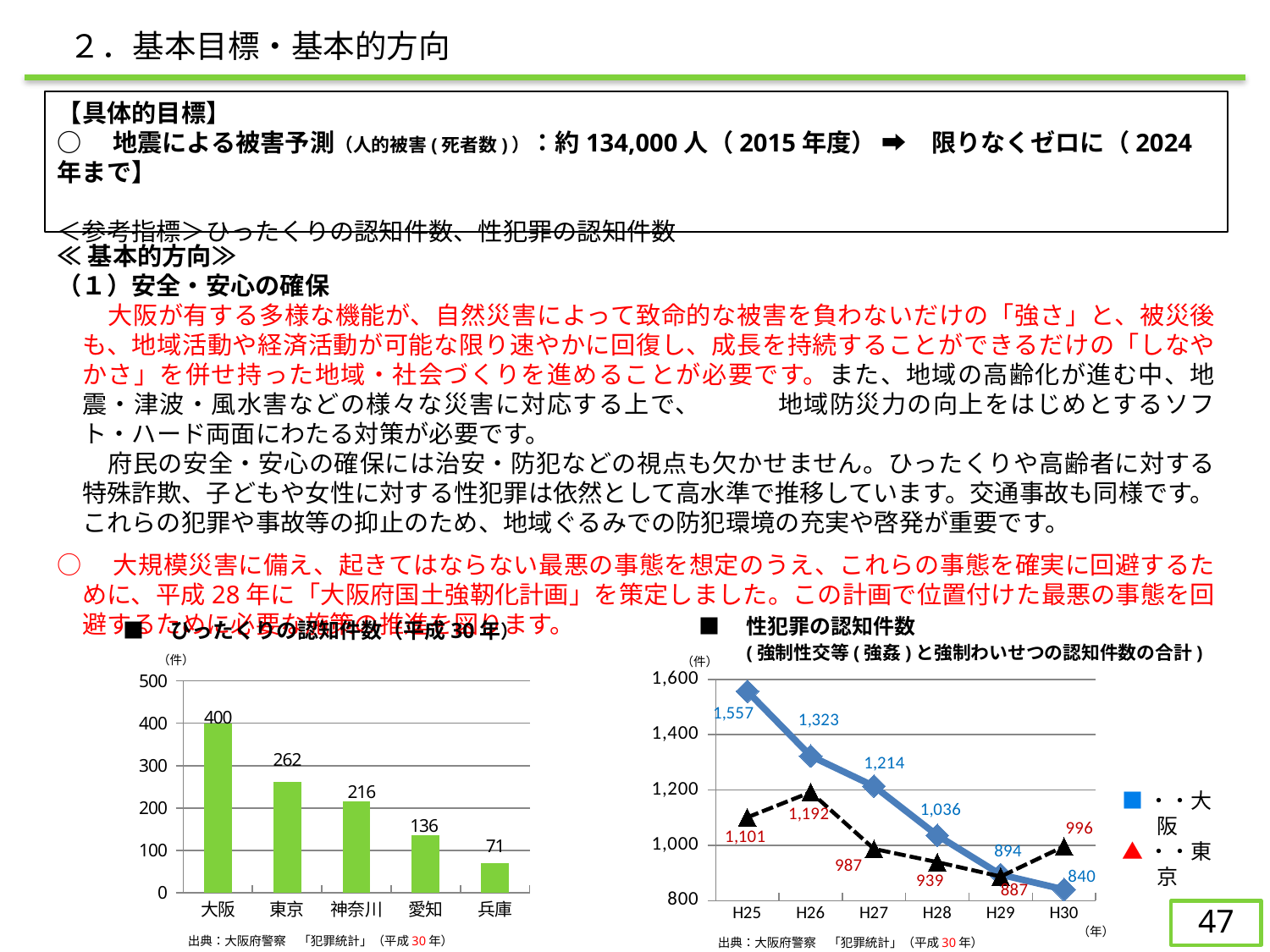
In the ひったくりの認知件数（平成30年） chart, what is the value for 大阪? 400 In the 性犯罪の認知件数 chart, what is the value for 大阪 in H25? 1,557 In the 性犯罪の認知件数 chart, in which year is the 大阪 value lowest? H30 What kind of chart is the ひったくりの認知件数（平成30年） chart? bar chart In the ひったくりの認知件数（平成30年） chart, what is the difference between 東京 and 神奈川? 46 In the 性犯罪の認知件数 chart, what is the value for 東京 in H30? 996 In the ひったくりの認知件数（平成30年） chart, do the values rise or fall from left to right? fall In the ひったくりの認知件数（平成30年） chart, how many prefectures are shown? 5 In the 性犯罪の認知件数 chart, which is larger in H27, 大阪 or 東京? 大阪 In the ひったくりの認知件数（平成30年） chart, which prefecture has the lowest value? 兵庫 In the 性犯罪の認知件数 chart, what is the difference between 大阪 and 東京 in H28? 97 How many series does the legend of the 性犯罪の認知件数 chart list? 2